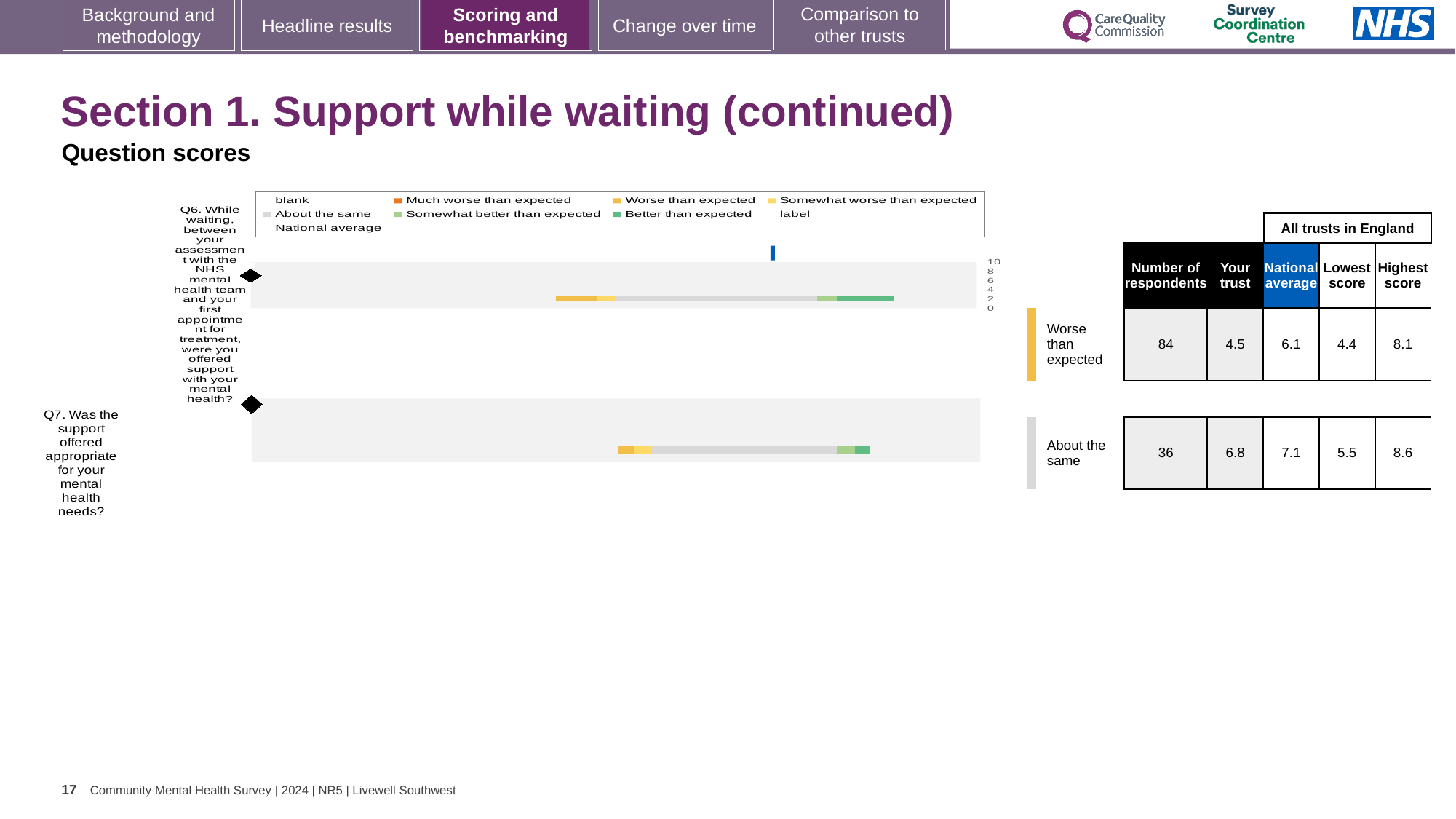
What is the national average score for Q6? 6.1 What kind of chart is shown on the slide? bar chart What is the lowest score among all trusts in England for Q6? 4.4 How many respondents answered Q6? 84 How many survey questions are plotted in the chart? 2 What is the difference between the highest and lowest scores for Q6 across all trusts in England? 3.7 What benchmark category is shown for Q6? Worse than expected What is the 'Your trust' score for Q7 (was the support offered appropriate for your mental health needs)? 6.8 What is the difference between the national average and the 'Your trust' score for Q7? 0.3 What is the 'Your trust' score for Q6 (support while waiting between assessment and first appointment)? 4.5 What is the highest score among all trusts in England for Q7? 8.6 Which question has the higher 'Your trust' score, Q6 or Q7? Q7